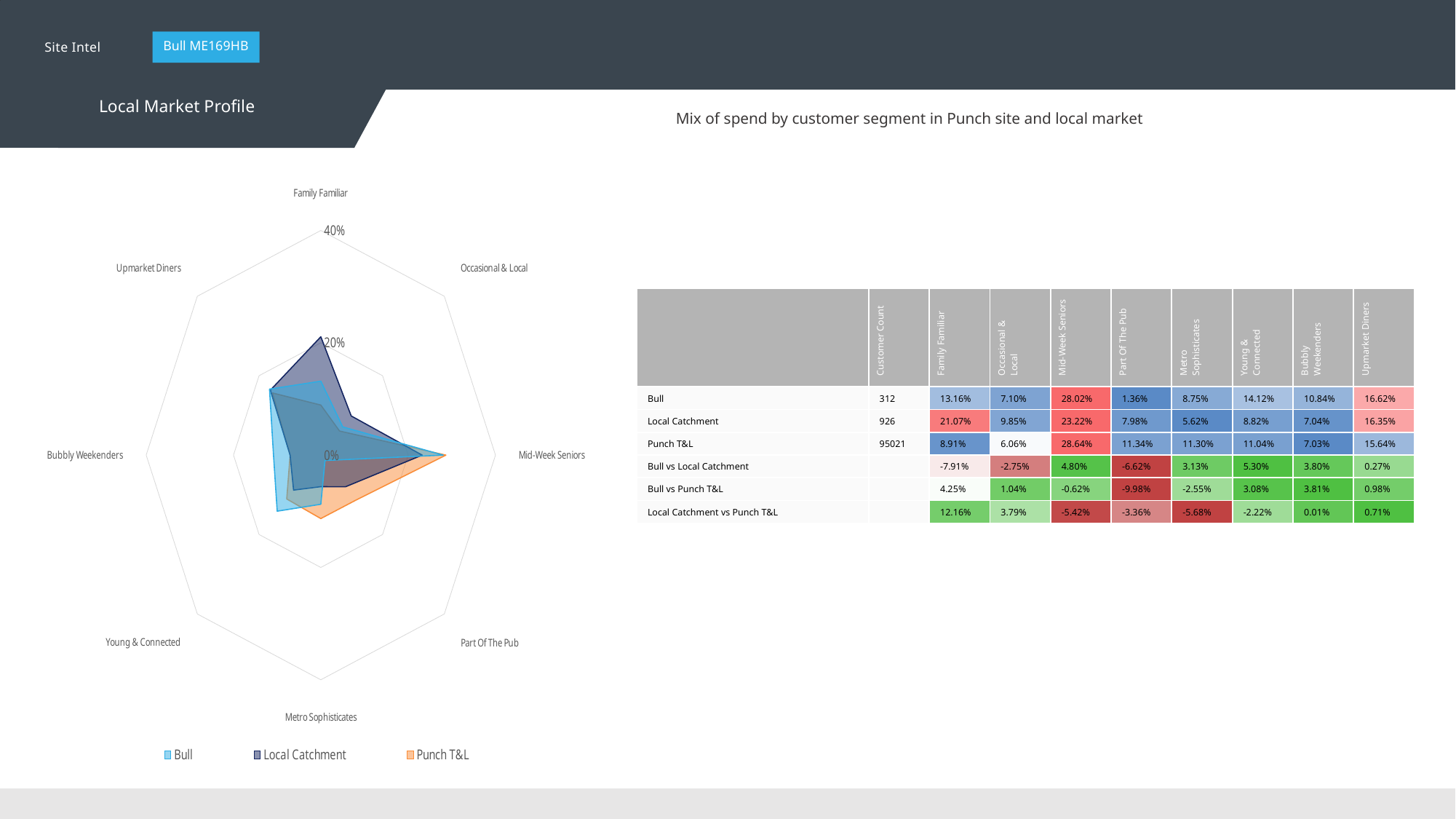
Which customer segment has the highest value for the Bull series? Mid-Week Seniors How many customer segment categories are plotted on the radar chart? 8 What kind of chart is shown on the left of the slide? Radar chart Is the Punch T&L value for Mid-Week Seniors greater or less than 20%? greater What is the highest percentage tick shown on the radar chart's axis? 40% Which customer segment has the lowest value for the Bull series? Part Of The Pub Which colour represents the Punch T&L series in the radar chart legend? Orange How many series does the legend of the radar chart list? 3 For Family Familiar, which is larger: Bull or Local Catchment? Local Catchment What is the Local Catchment value for Family Familiar? 21.07% What is the difference between the Local Catchment and Bull values for Family Familiar? 7.91% What is the Punch T&L value for Mid-Week Seniors? 28.64%